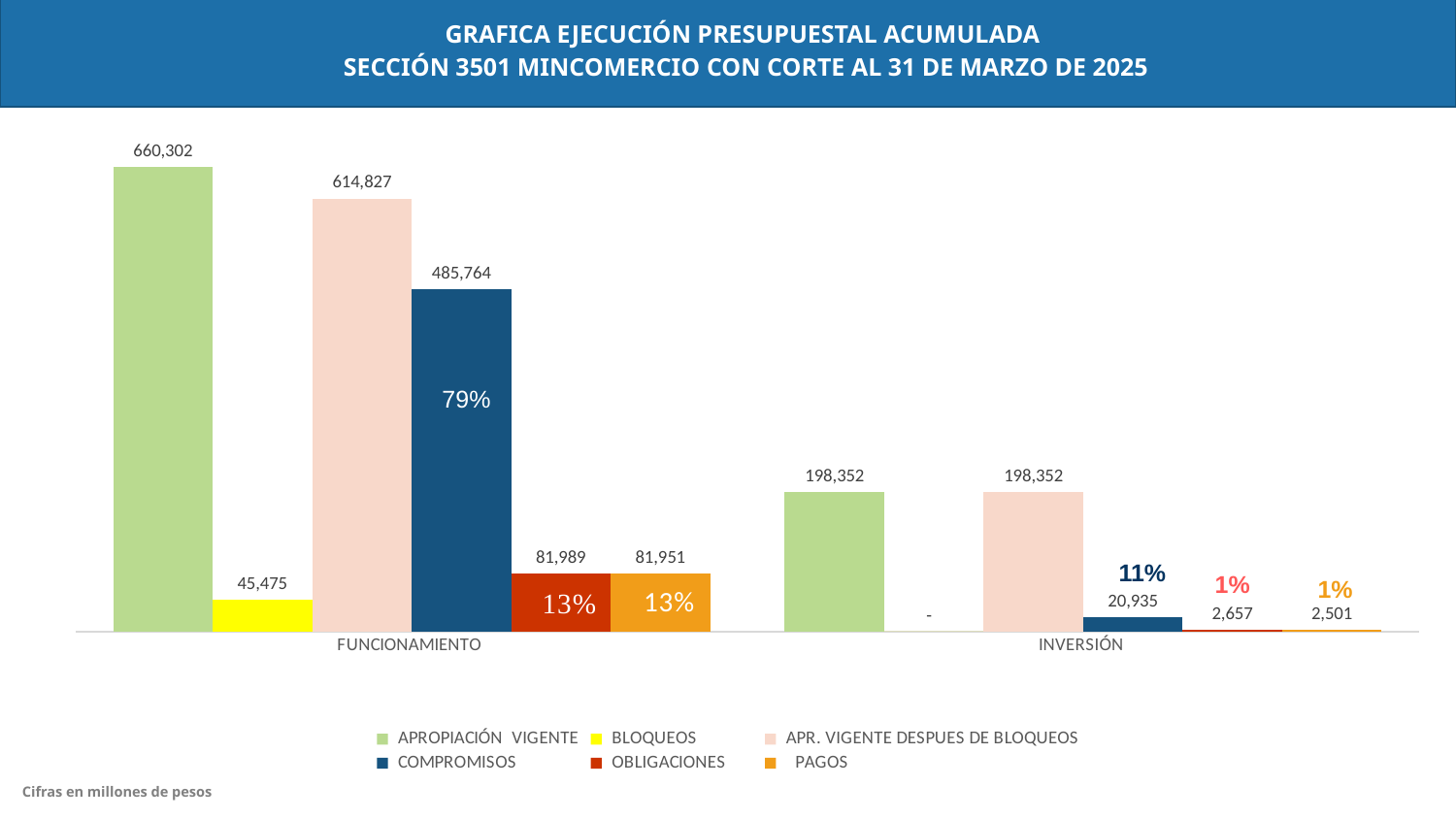
What kind of chart is shown on the slide? Bar chart How many categories are shown on the x axis? 2 What is the difference between APROPIACIÓN VIGENTE and APR. VIGENTE DESPUES DE BLOQUEOS for FUNCIONAMIENTO? 45,475 Which is larger for FUNCIONAMIENTO: OBLIGACIONES or COMPROMISOS? COMPROMISOS What is the value of PAGOS for INVERSIÓN? 2,501 What is the difference between OBLIGACIONES and PAGOS for INVERSIÓN? 156 What is the value of APROPIACIÓN VIGENTE for FUNCIONAMIENTO? 660,302 What percentage label is shown on the COMPROMISOS bar for FUNCIONAMIENTO? 79% What is the value of BLOQUEOS for FUNCIONAMIENTO? 45,475 How many series does the legend list? 6 What is the value of COMPROMISOS for INVERSIÓN? 20,935 Which series has the lowest value for FUNCIONAMIENTO? BLOQUEOS